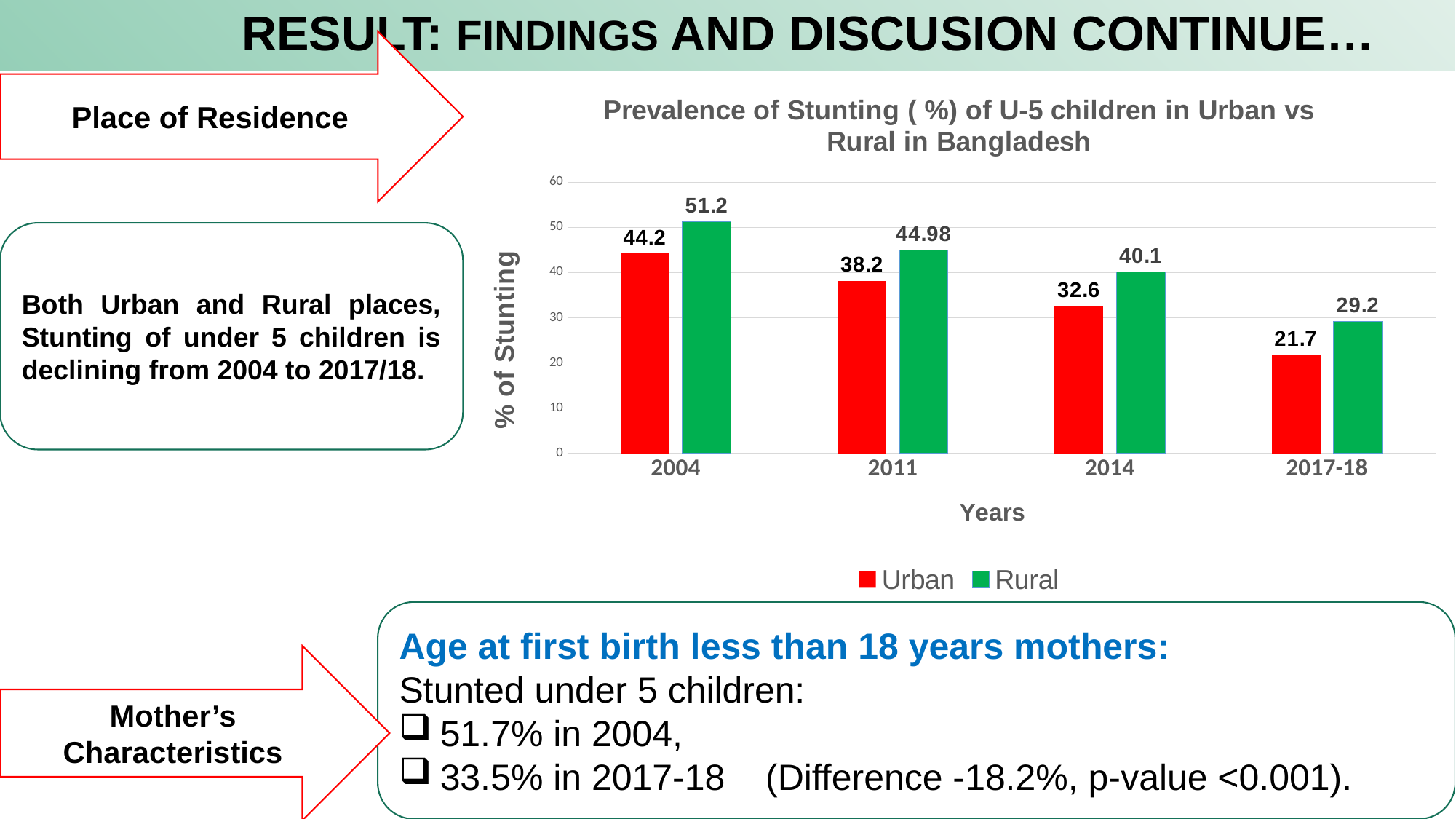
Do the Urban values rise or fall from 2004 to 2017-18? fall What is the Rural stunting prevalence in 2011? 44.98 Is the Urban value for 2017-18 greater or less than 30? less What kind of chart is shown? bar chart What is the Urban stunting prevalence in 2004? 44.2 Which year has the highest Rural stunting prevalence? 2004 What is the difference between the Rural and Urban values in 2014? 7.5 What is the Rural value for 2017-18? 29.2 In 2011, which is larger, the Urban or the Rural value? Rural How many years are shown on the x axis? 4 Which year has the lowest Urban stunting prevalence? 2017-18 How many series does the legend list? 2